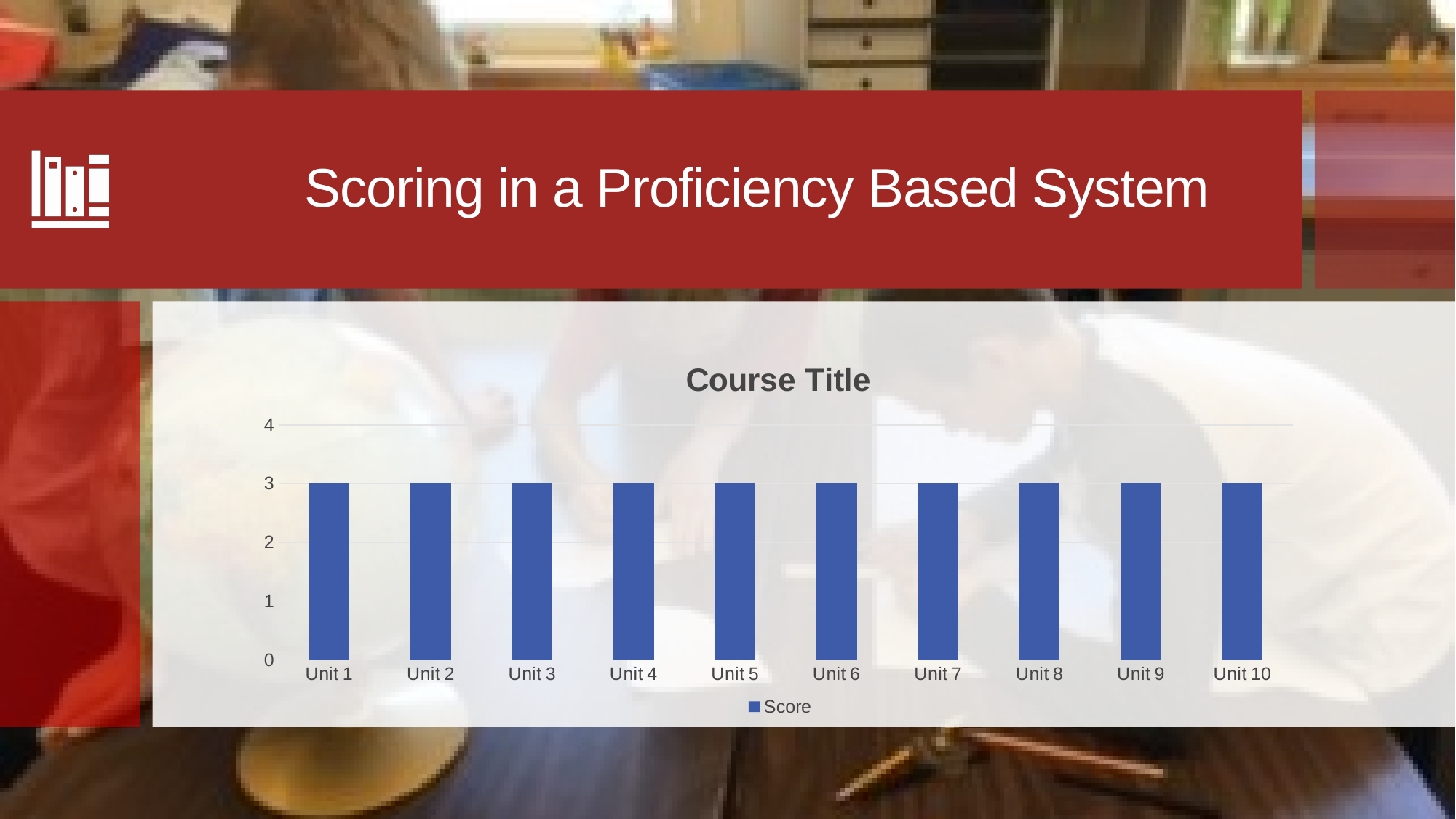
Do the Score values rise, fall, or stay the same from Unit 1 to Unit 10? stay the same What is the Score value for Unit 5? 3 What type of chart is shown on the slide? bar chart How many categories are shown on the x axis of the chart? 10 What is the Score value for Unit 10? 3 What is the title of the chart? Course Title What is the difference between the Score for Unit 2 and the Score for Unit 8? 0 Is the value for Unit 7 greater or less than 2? greater What is the Score value for Unit 1? 3 How many series does the chart's legend list? 1 Is the value for Unit 3 greater or less than 4? less What series name appears in the chart's legend? Score